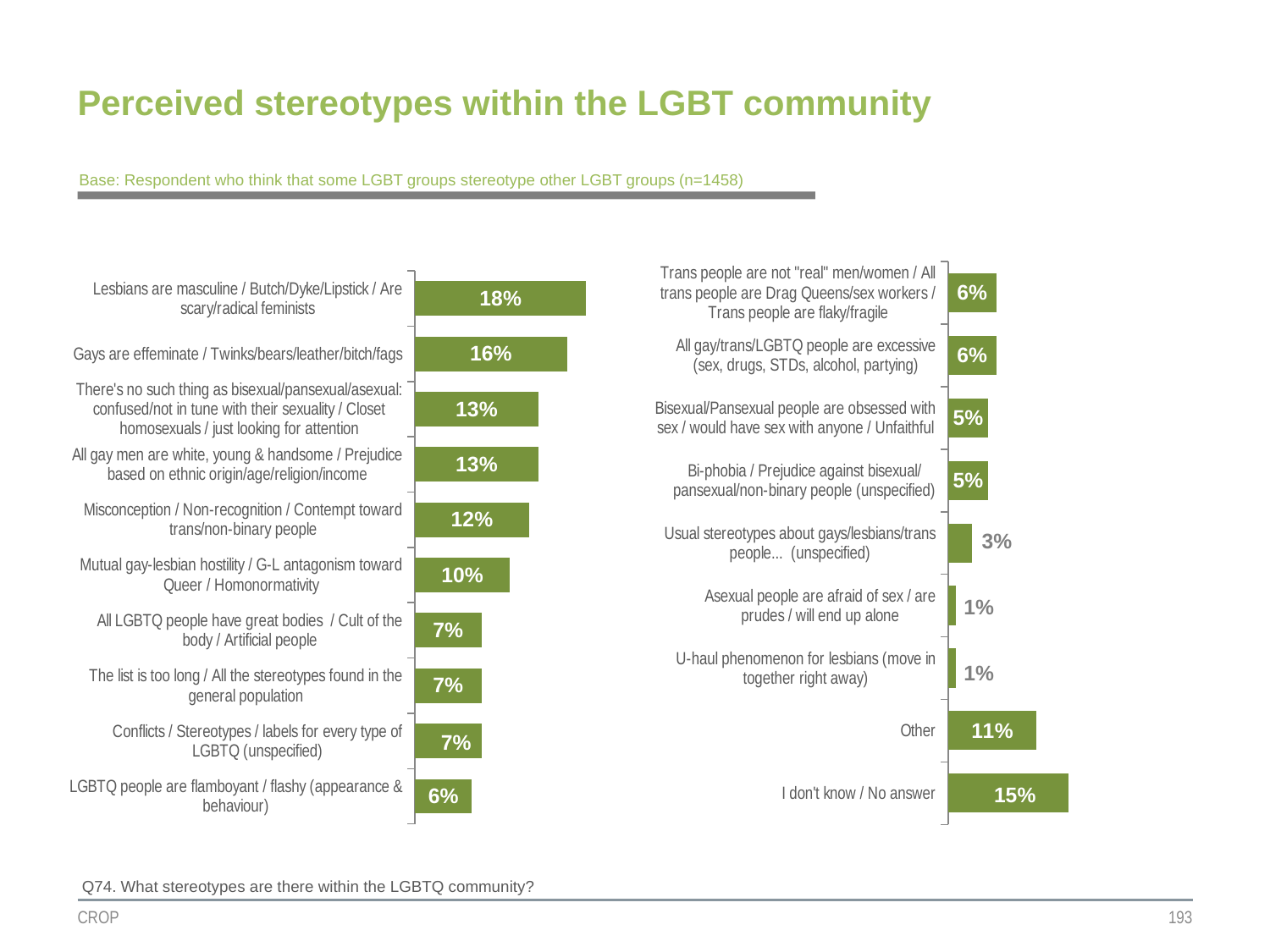
In the right chart, what percentage is shown for "Other"? 11% In the left chart, what percentage is shown for "Gays are effeminate / Twinks/bears/leather/bitch/fags"? 16% In the left chart, what is the difference between the value for "Lesbians are masculine / Butch/Dyke/Lipstick / Are scary/radical feminists" and the value for "Misconception / Non-recognition / Contempt toward trans/non-binary people"? 6% How many categories are shown in the left chart? 10 How many categories are shown in the right chart? 9 In the left chart, which category has the highest value? Lesbians are masculine / Butch/Dyke/Lipstick / Are scary/radical feminists In the right chart, which category has the highest value? I don't know / No answer In the left chart, what is the value for "Mutual gay-lesbian hostility / G-L antagonism toward Queer / Homonormativity"? 10% In the left chart, which category has the lowest value? LGBTQ people are flamboyant / flashy (appearance & behaviour) In the right chart, which is larger: the value for "I don't know / No answer" or the value for "Other"? I don't know / No answer In the right chart, what is the value for "Usual stereotypes about gays/lesbians/trans people... (unspecified)"? 3% What type of chart is used on this slide? Bar chart